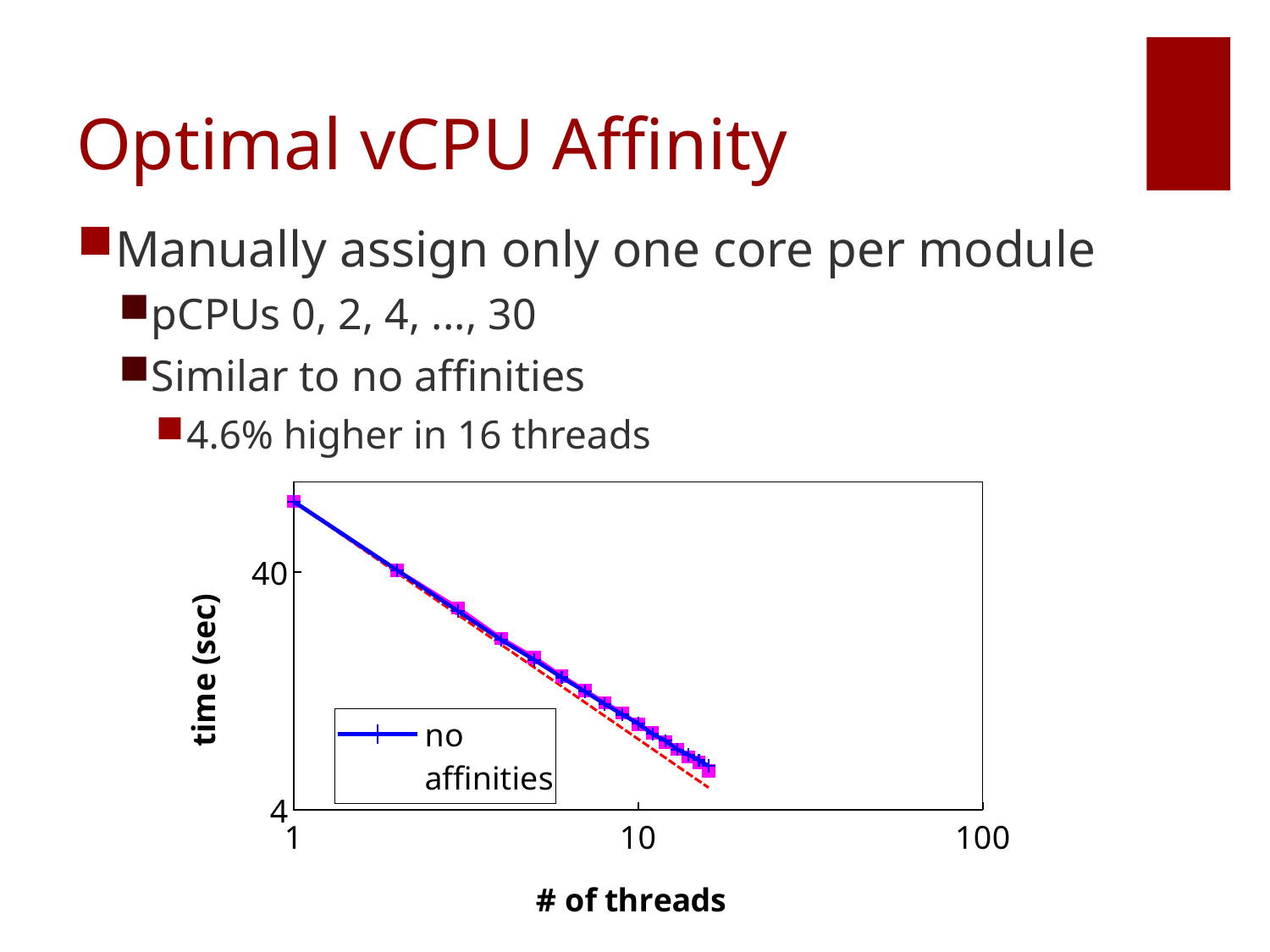
Does the time decrease or increase as the number of threads increases? decrease What is the label of the y axis of the chart? time (sec) Which has the higher time: 1 thread or 10 threads? 1 thread How many series does the chart's legend list? 1 What kind of chart is shown on the slide? line chart Is the time for 10 threads greater or less than 40 seconds? less At which number of threads is the time highest? 1 Is the time for 1 thread greater or less than 40 seconds? greater What is the label of the x axis of the chart? # of threads Is the time at the largest number of threads plotted greater or less than 4 seconds? greater